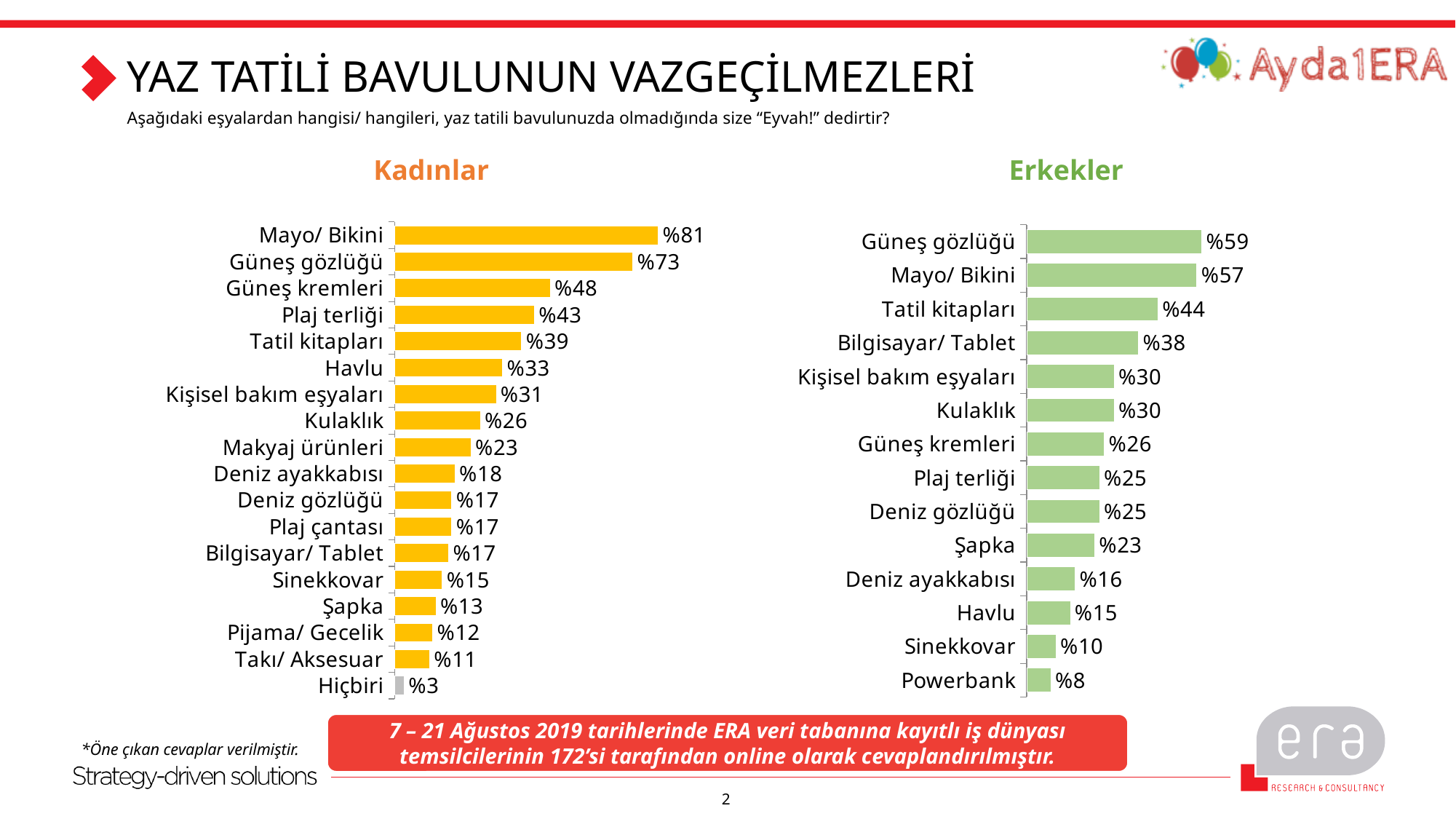
In the Erkekler chart, what is the value for Tatil kitapları? %44 In the Kadınlar chart, what is the value for Hiçbiri? %3 In the Kadınlar chart, what is the value for Güneş gözlüğü? %73 In the Erkekler chart, what is the difference between Güneş gözlüğü and Bilgisayar/ Tablet? %21 In the Erkekler chart, which category has the lowest value? Powerbank In the Kadınlar chart, what is the difference between Mayo/ Bikini and Güneş gözlüğü? %8 In the Kadınlar chart, which is larger: Havlu or Kulaklık? Havlu In the Kadınlar chart, which category has the highest value? Mayo/ Bikini How many categories are shown in the Kadınlar chart? 18 What kind of chart is the Erkekler chart? Bar chart How many categories are shown in the Erkekler chart? 14 In the Erkekler chart, which is larger: Şapka or Deniz ayakkabısı? Şapka